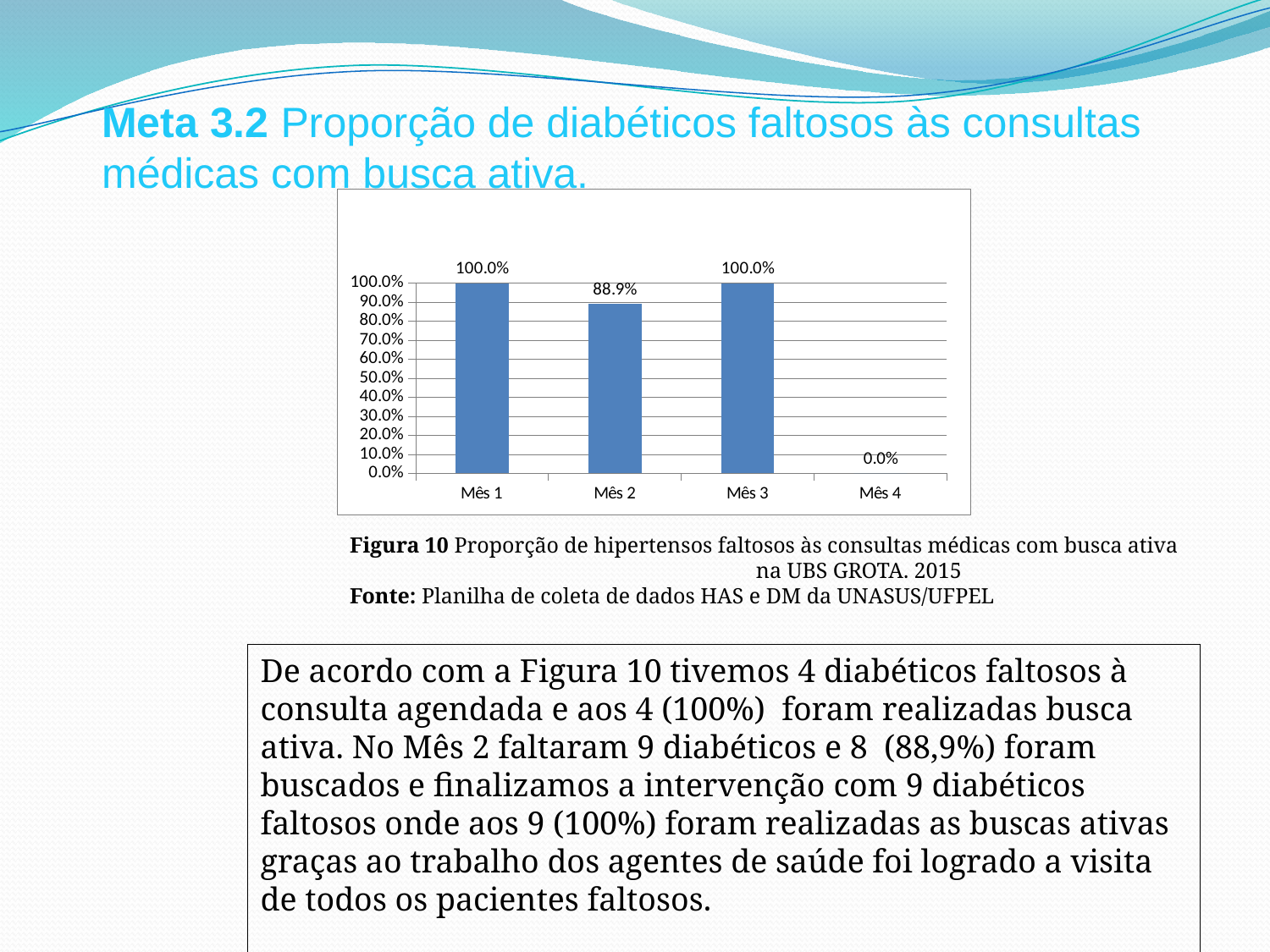
Is the value for Mês 2 greater or less than 80.0%? greater What is the value for Mês 3? 100.0% How many months are shown on the x axis? 4 Which is larger, the value for Mês 2 or the value for Mês 3? Mês 3 What is the value for Mês 2? 88.9% What is the value for Mês 4? 0.0% What colour are the bars in the chart? blue What kind of chart is shown on the slide? bar chart What is the value for Mês 1? 100.0% What is the difference between the values for Mês 1 and Mês 2? 11.1% Which month has the lowest value? Mês 4 What is the highest value shown on the y axis? 100.0%